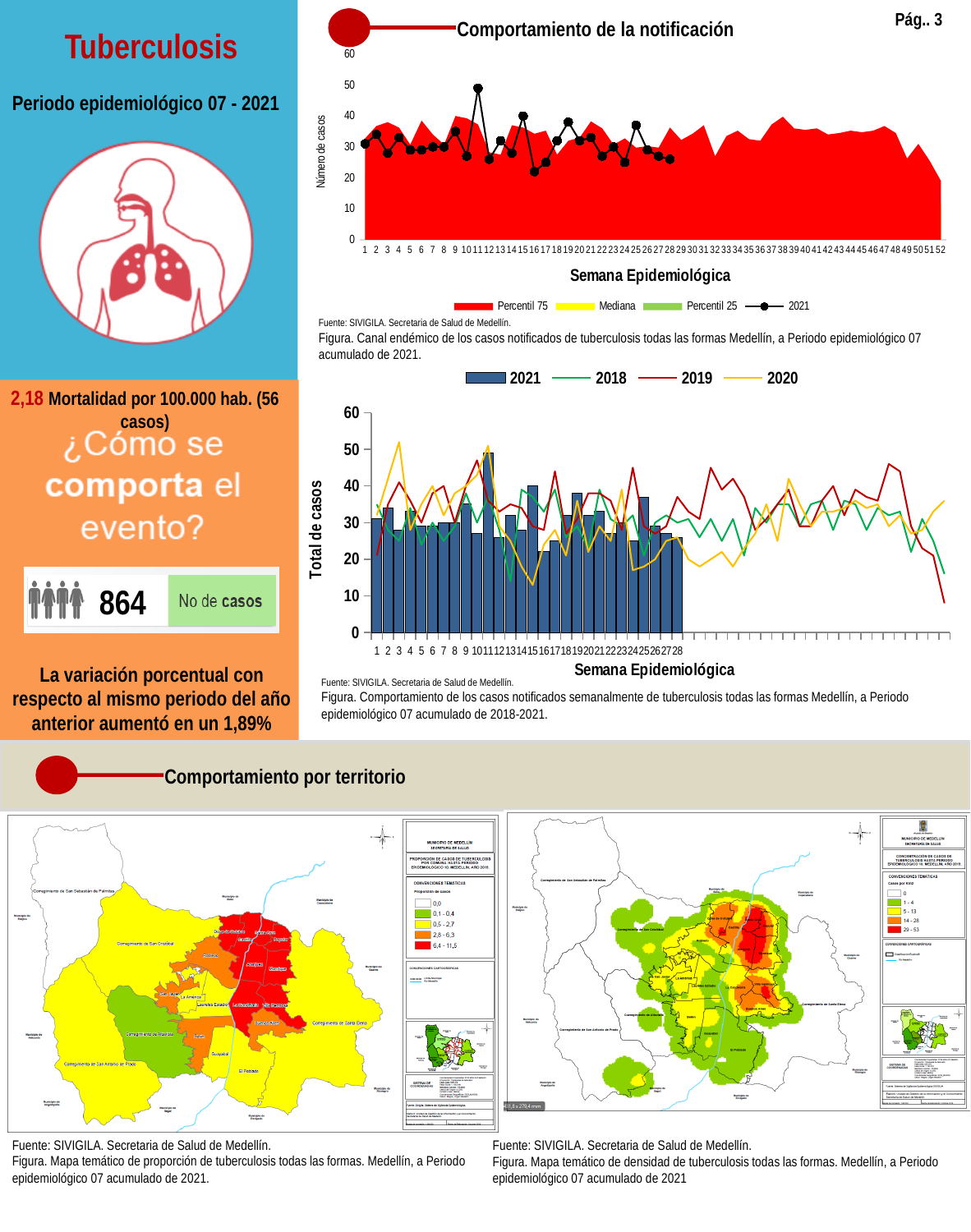
In the 'Comportamiento de la notificación' chart, how many epidemiological weeks are shown on the x axis? 52 In the bottom chart (2018-2021 weekly cases), what is the y-axis title? Total de casos In the 'Comportamiento de la notificación' chart, how many series does the legend list? 4 In the bottom chart (2018-2021 weekly cases), is the 2021 bar at week 16 greater or less than 30? less In the 'Comportamiento de la notificación' chart, what colour represents Percentil 75? Red In the 'Comportamiento de la notificación' chart, is the 2021 value at week 16 greater or less than 30? less In the bottom chart (2018-2021 weekly cases), up to which week are 2021 bars plotted? Week 28 In the bottom chart (2018-2021 weekly cases), at which week is the 2021 bar highest? Week 11 In the bottom chart (2018-2021 weekly cases), which series is drawn as bars? 2021 In the 'Comportamiento de la notificación' chart, is the 2021 value at week 11 greater or less than 40? greater In the bottom chart (2018-2021 weekly cases), how many series does the legend list? 4